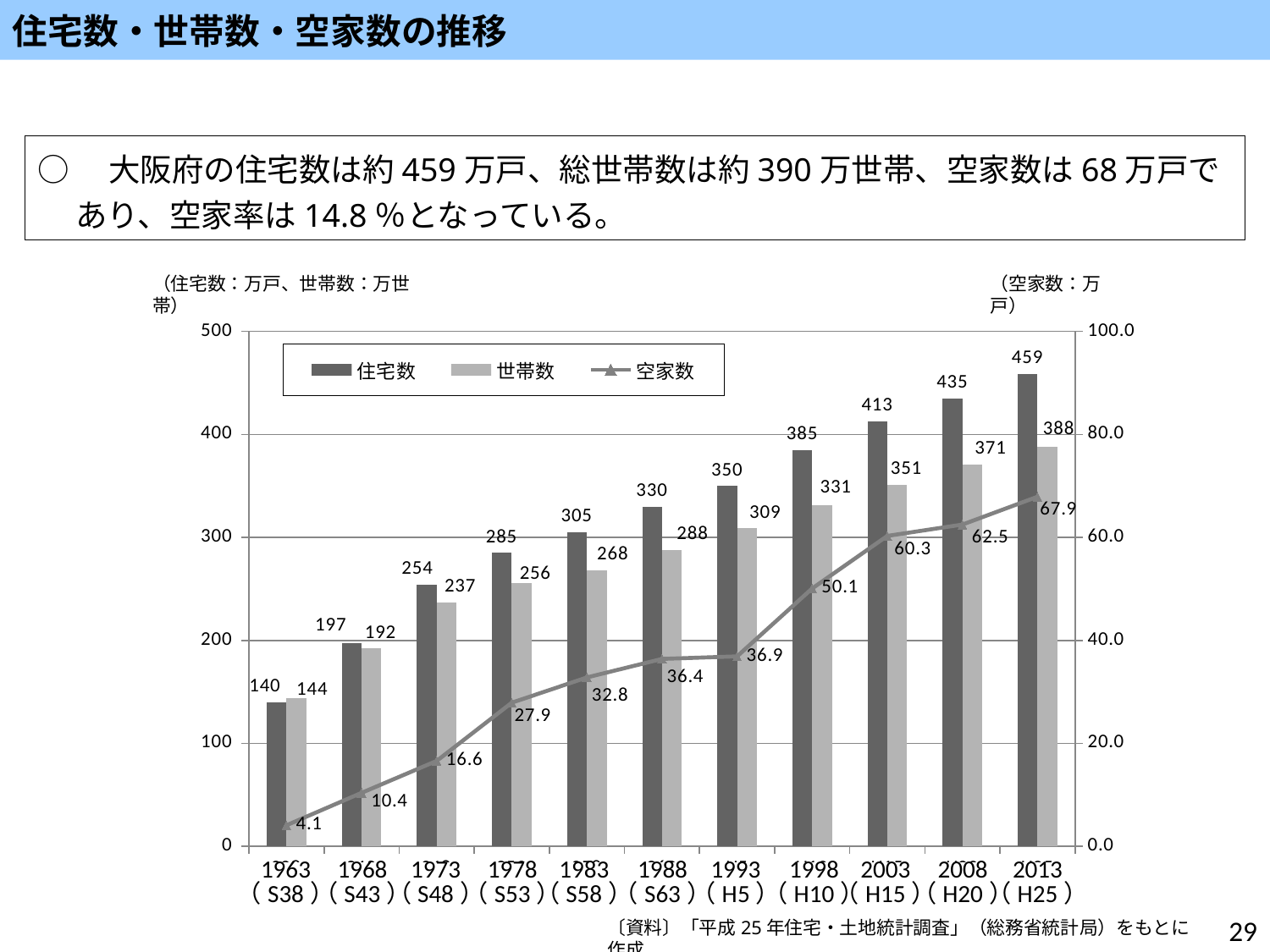
In which year is 空家数 the highest? 2013 (H25) What is the value of 空家数 for 2003 (H15)? 60.3 What is the value of 住宅数 for 2013 (H25)? 459 Which is larger in 1963 (S38), 住宅数 or 世帯数? 世帯数 Does 住宅数 rise or fall from 1963 to 2013? rise What kind of chart is used for 空家数? line chart In which year is 住宅数 the lowest? 1963 (S38) What is the difference in 空家数 between 2008 (H20) and 2013 (H25)? 5.4 What is the value of 世帯数 for 1993 (H5)? 309 How many years are shown on the x axis? 11 What is the difference between 住宅数 and 世帯数 in 2013 (H25)? 71 How many series does the legend list? 3